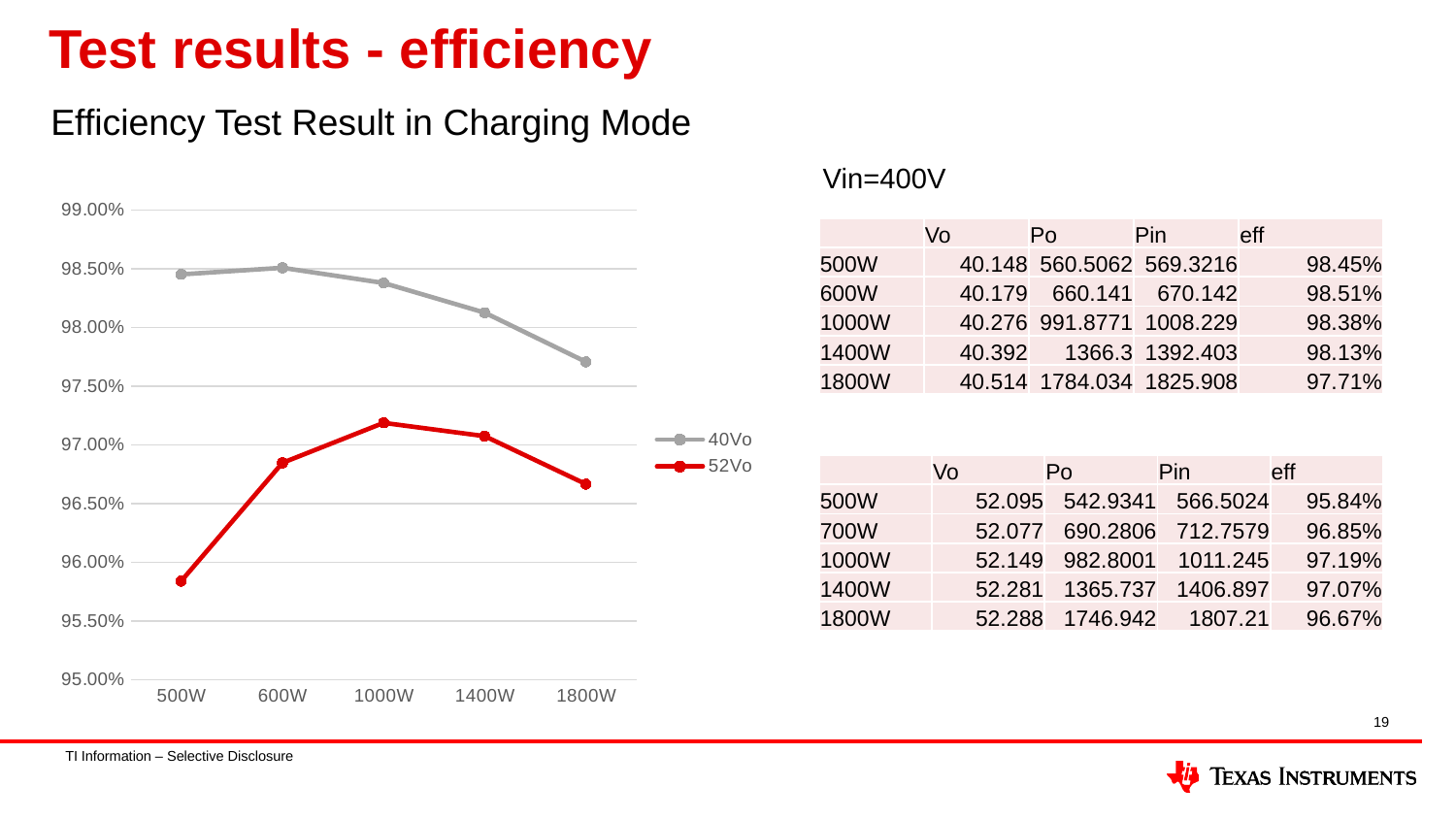
At which power level is the 52Vo efficiency lowest? 500W Does the 52Vo efficiency rise or fall from 1000W to 1800W? fall According to the Vin=400V table, what is the efficiency for 40Vo at 500W? 98.45% At which power level is the 40Vo efficiency lowest? 1800W At 1800W, which series has the higher efficiency, 40Vo or 52Vo? 40Vo Is the 52Vo efficiency at 500W greater or less than 96.00%? less What kind of chart is shown on the slide? line chart At which power level is the 52Vo efficiency highest? 1000W Is the 40Vo efficiency at 1800W greater or less than 97.50%? greater How many power levels are shown on the x axis of the chart? 5 How many series does the chart legend list? 2 What colour is the 52Vo line in the chart? red